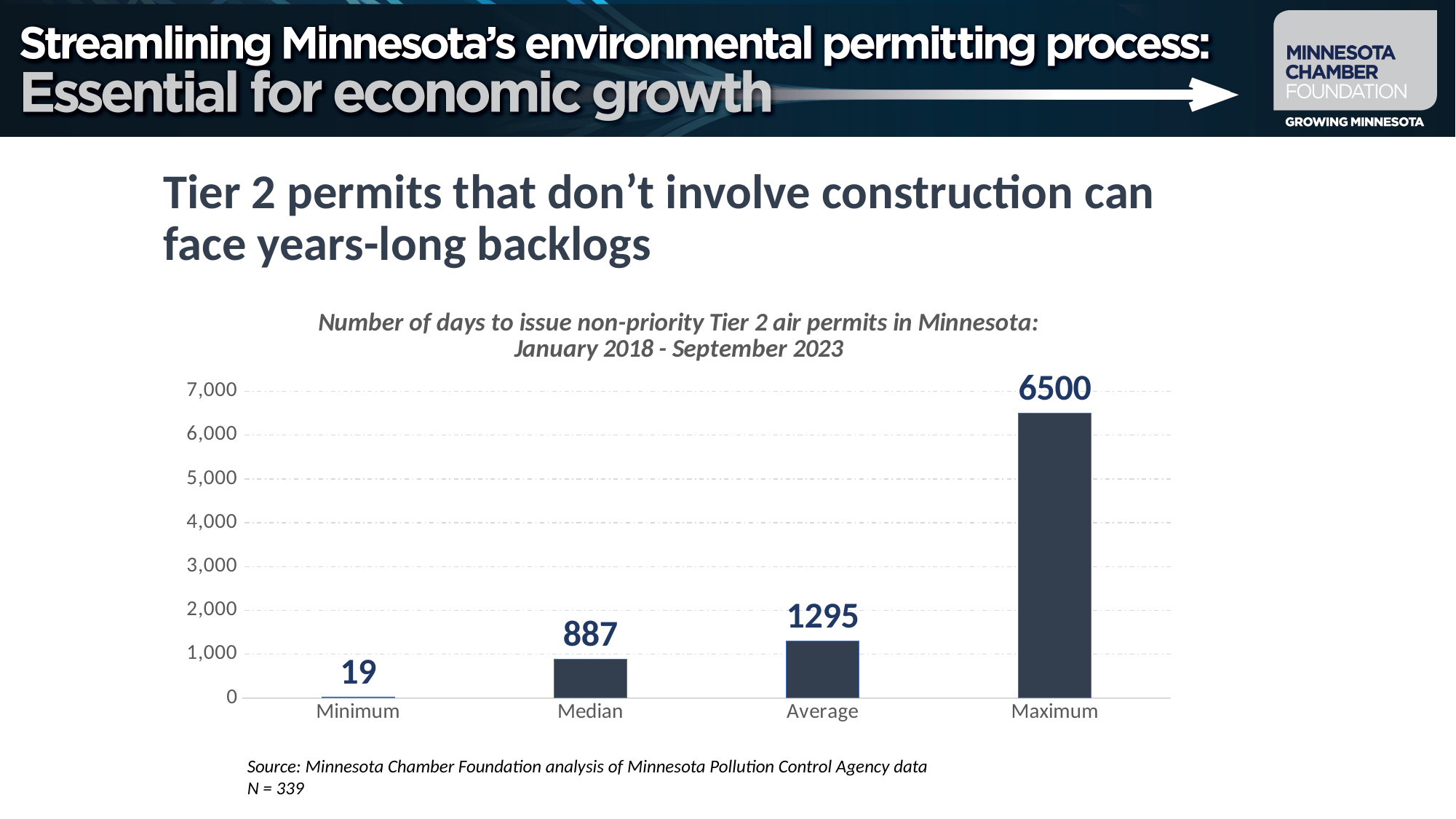
What is the value for Minimum? 19 What is the value for Median? 887 Which category has the lowest value? Minimum What is the value for Maximum? 6500 What kind of chart is shown on the slide? bar chart What is the difference between the Average and Median values? 408 What is the difference between the Maximum and Average values? 5205 How many categories are shown on the x axis? 4 Which category has the highest value? Maximum Which is larger, the Median or the Average value? Average Is the value for Maximum greater or less than 6,000? greater What is the value for Average? 1295